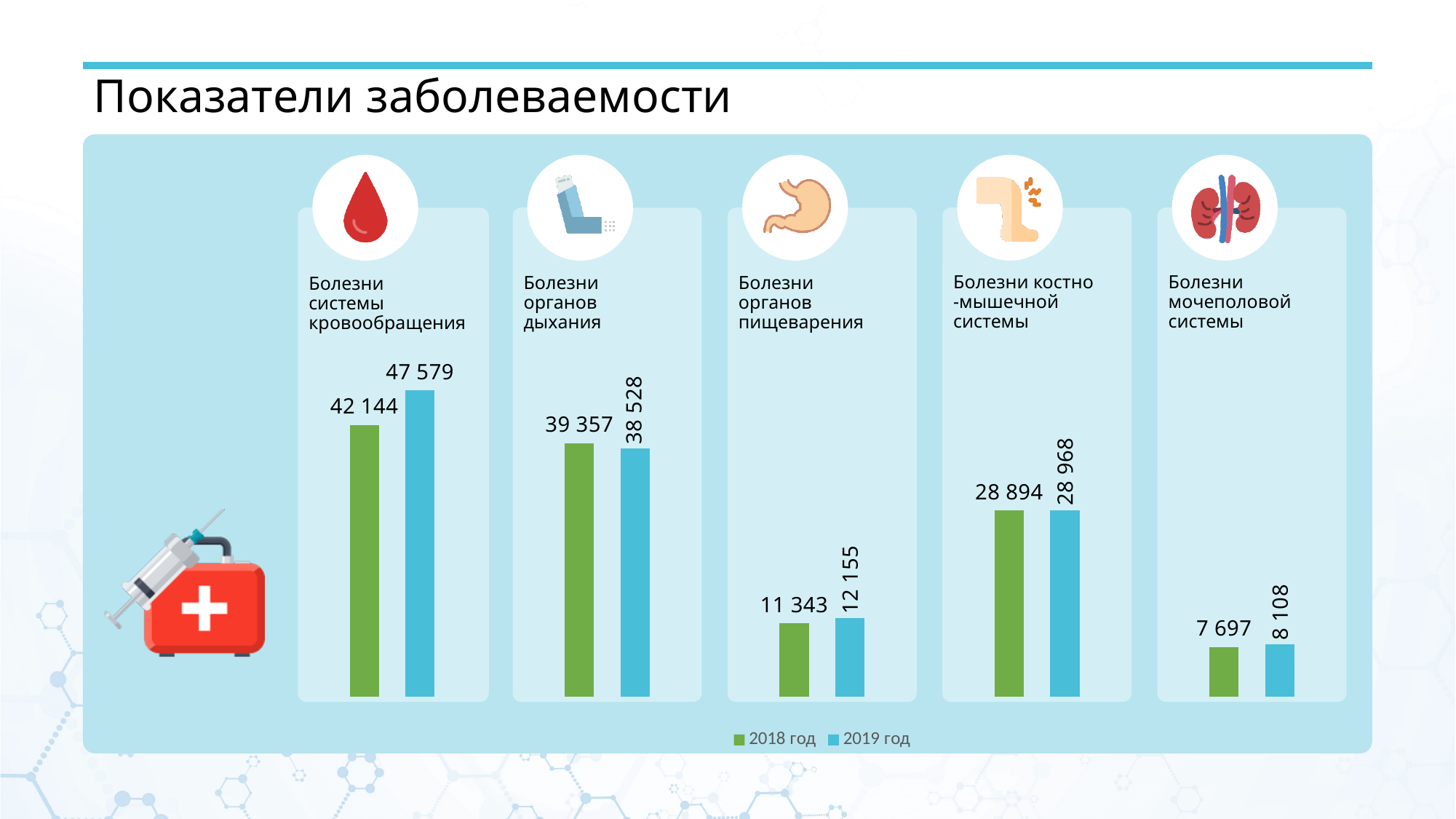
What type of chart is shown on the slide? Bar chart What is the 2018 год value for Болезни органов дыхания? 39 357 Which category has the highest 2019 год value? Болезни системы кровообращения How many disease categories are shown in the chart? 5 What is the 2018 год value for Болезни костно-мышечной системы? 28 894 How many series does the legend list? 2 What is the 2019 год value for Болезни мочеполовой системы? 8 108 Which category has the lowest 2018 год value? Болезни мочеполовой системы What is the difference between the 2019 год and 2018 год values for Болезни системы кровообращения? 5 435 For Болезни органов пищеварения, which year has the larger value, 2018 год or 2019 год? 2019 год What is the 2019 год value for Болезни системы кровообращения? 47 579 What is the difference between the 2018 год and 2019 год values for Болезни органов дыхания? 829